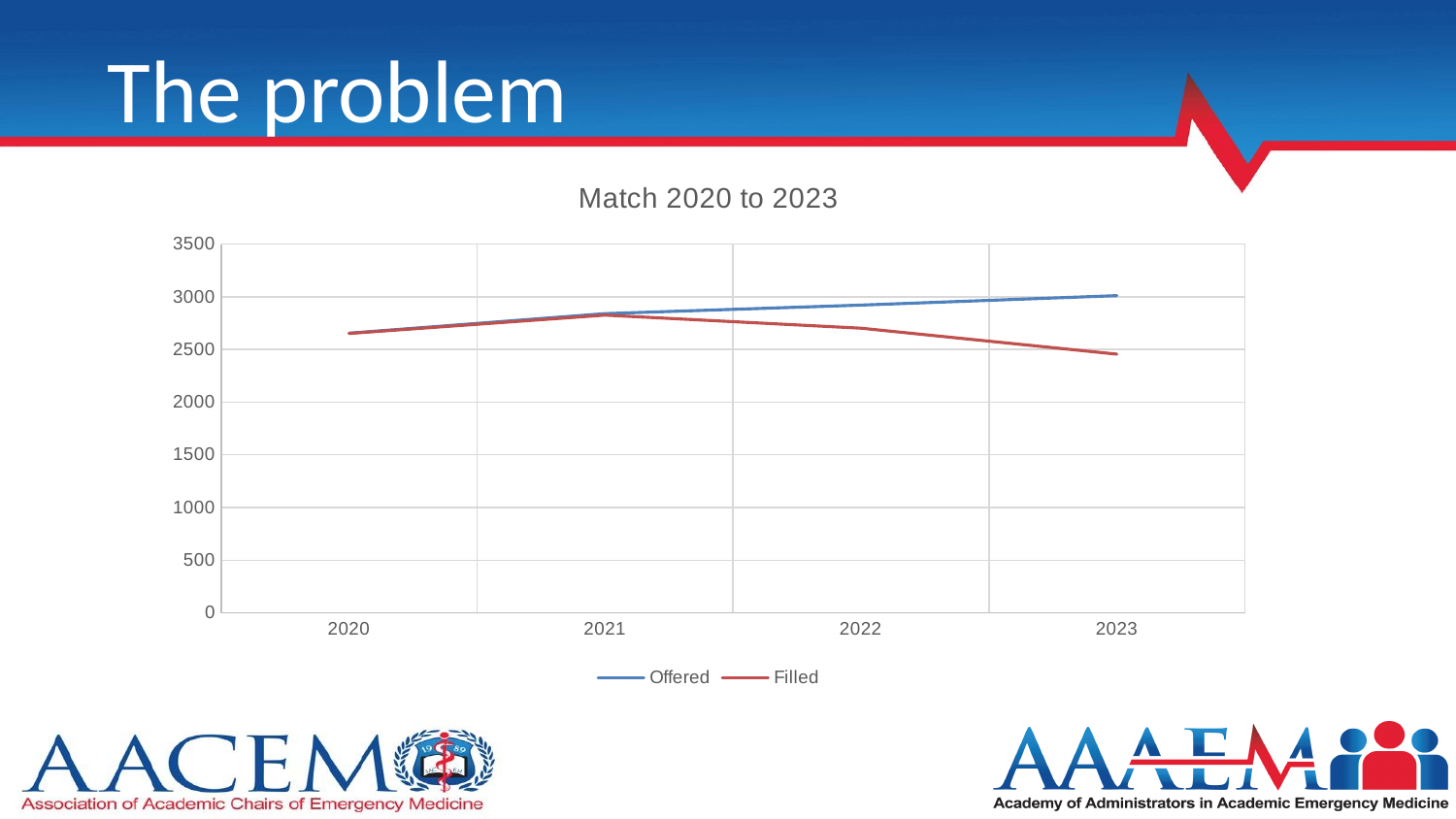
How many years are plotted along the x axis? 4 What kind of chart is shown on the slide? line chart How many series does the legend list? 2 What is the title of the chart? Match 2020 to 2023 Is the value for Filled in 2022 greater or less than 2500? greater Does the Offered series rise or fall from 2020 to 2023? rise Does the Filled series rise or fall from 2021 to 2023? fall In which year is the Filled series lowest? 2023 Is the value for Offered in 2022 greater or less than 3000? less In which year is the Offered series highest? 2023 What are the two series named in the legend? Offered and Filled In 2023, which is larger, Offered or Filled? Offered